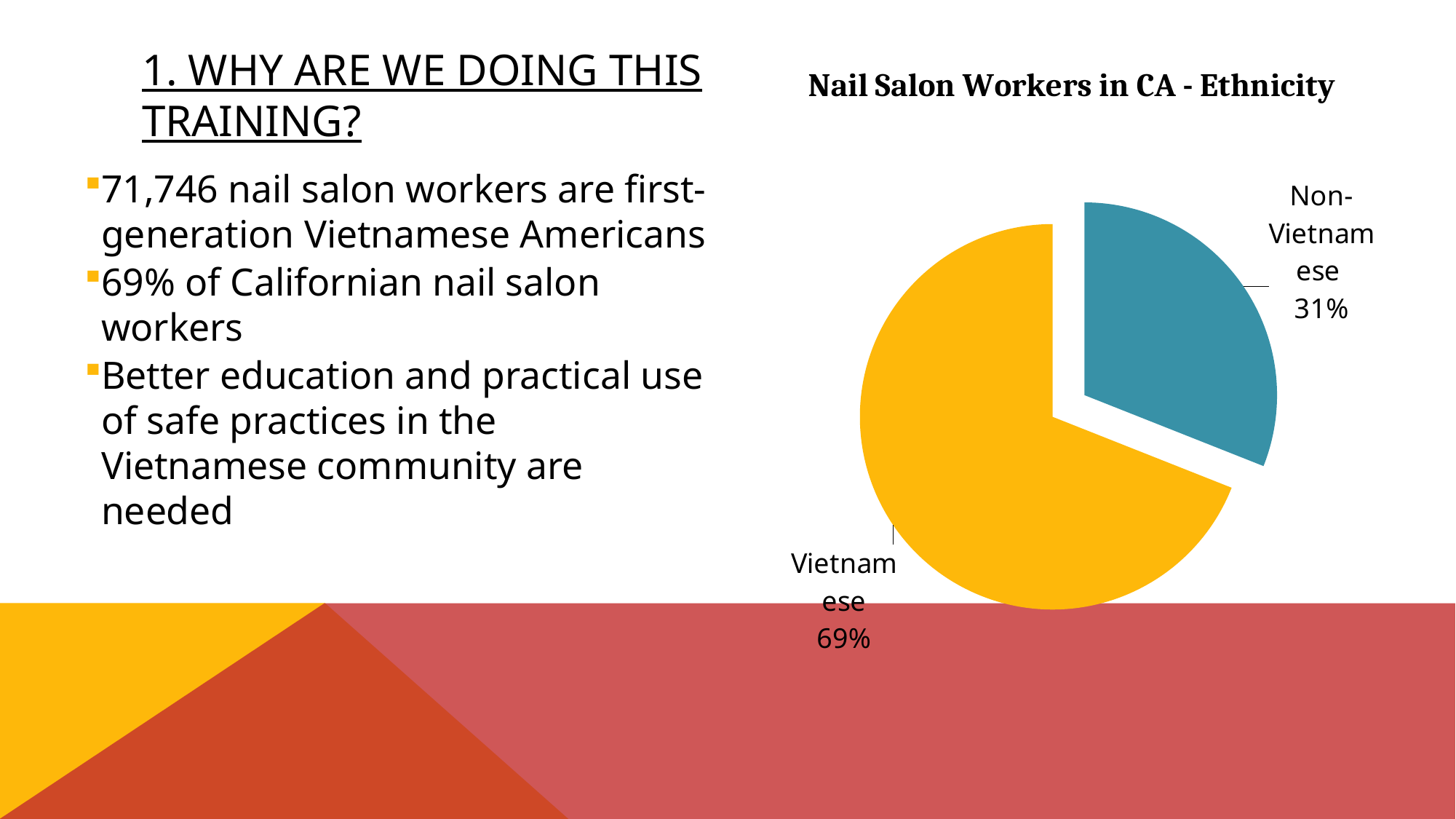
Which category has the smallest slice of the pie? Non-Vietnamese Which category has the largest slice of the pie? Vietnamese Which slice is larger, Vietnamese or Non-Vietnamese? Vietnamese What is the title of the chart? Nail Salon Workers in CA - Ethnicity What share of the pie is Non-Vietnamese? 31% What colour is the Non-Vietnamese slice? teal Is the share for Non-Vietnamese greater or less than 50%? less What is the difference in percentage points between the Vietnamese and Non-Vietnamese slices? 38 What share of the pie is Vietnamese? 69% What kind of chart is shown on the slide? pie chart How many slices does the pie chart have? 2